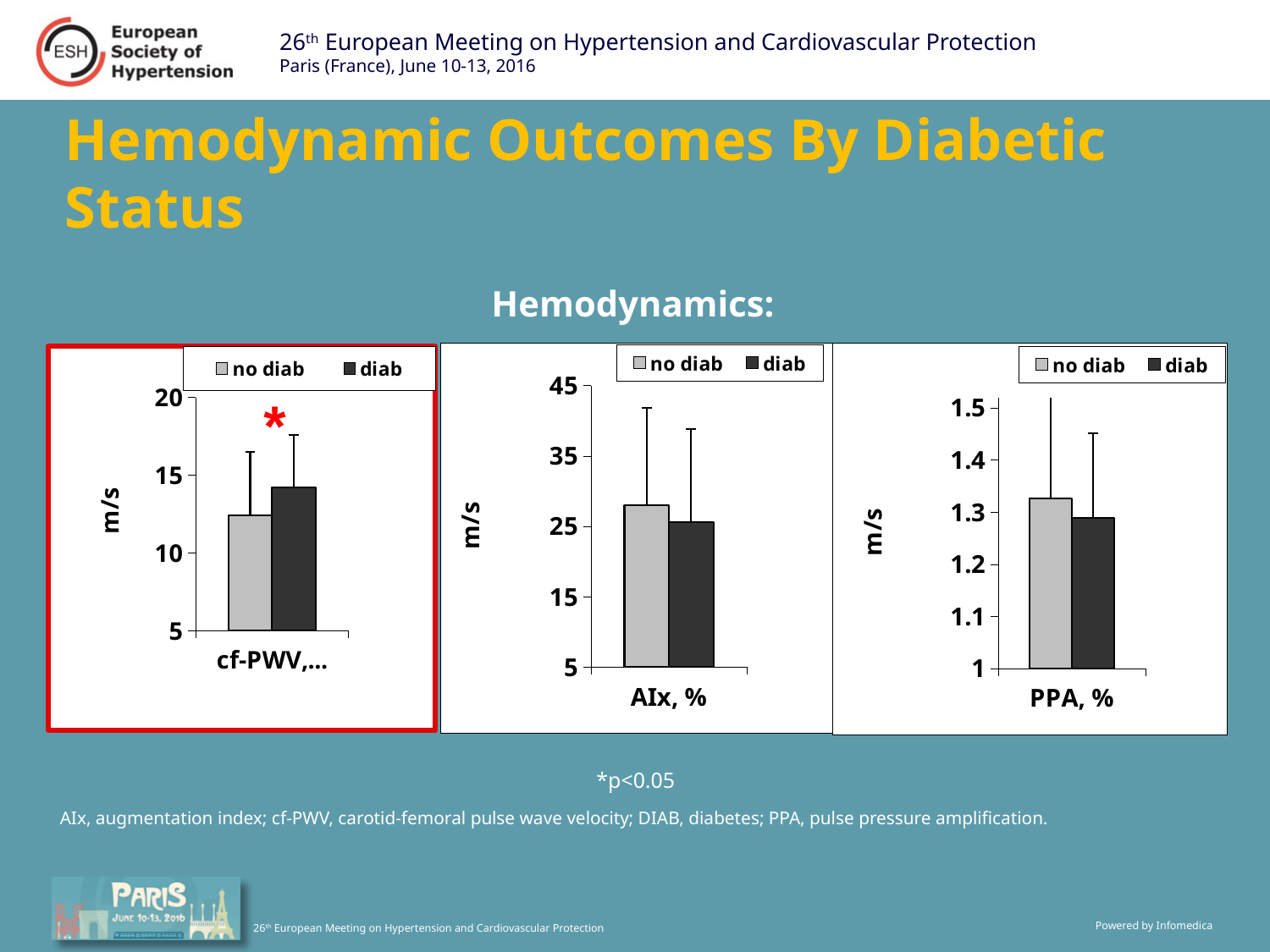
What are the two series named in the legend of the PPA, % chart? no diab and diab In the AIx, % chart, is the value for diab greater or less than 15? greater Which of the three charts is marked with a red asterisk indicating p<0.05? cf-PWV How many series does the legend of the AIx, % chart list? 2 In the cf-PWV chart, is the value for no diab greater or less than 15? less In the PPA, % chart, is the value for diab greater or less than 1.2? greater What kind of chart is the cf-PWV chart on the left? bar chart In the AIx, % chart, which bar is taller, no diab or diab? no diab In the cf-PWV chart, which bar is taller, no diab or diab? diab